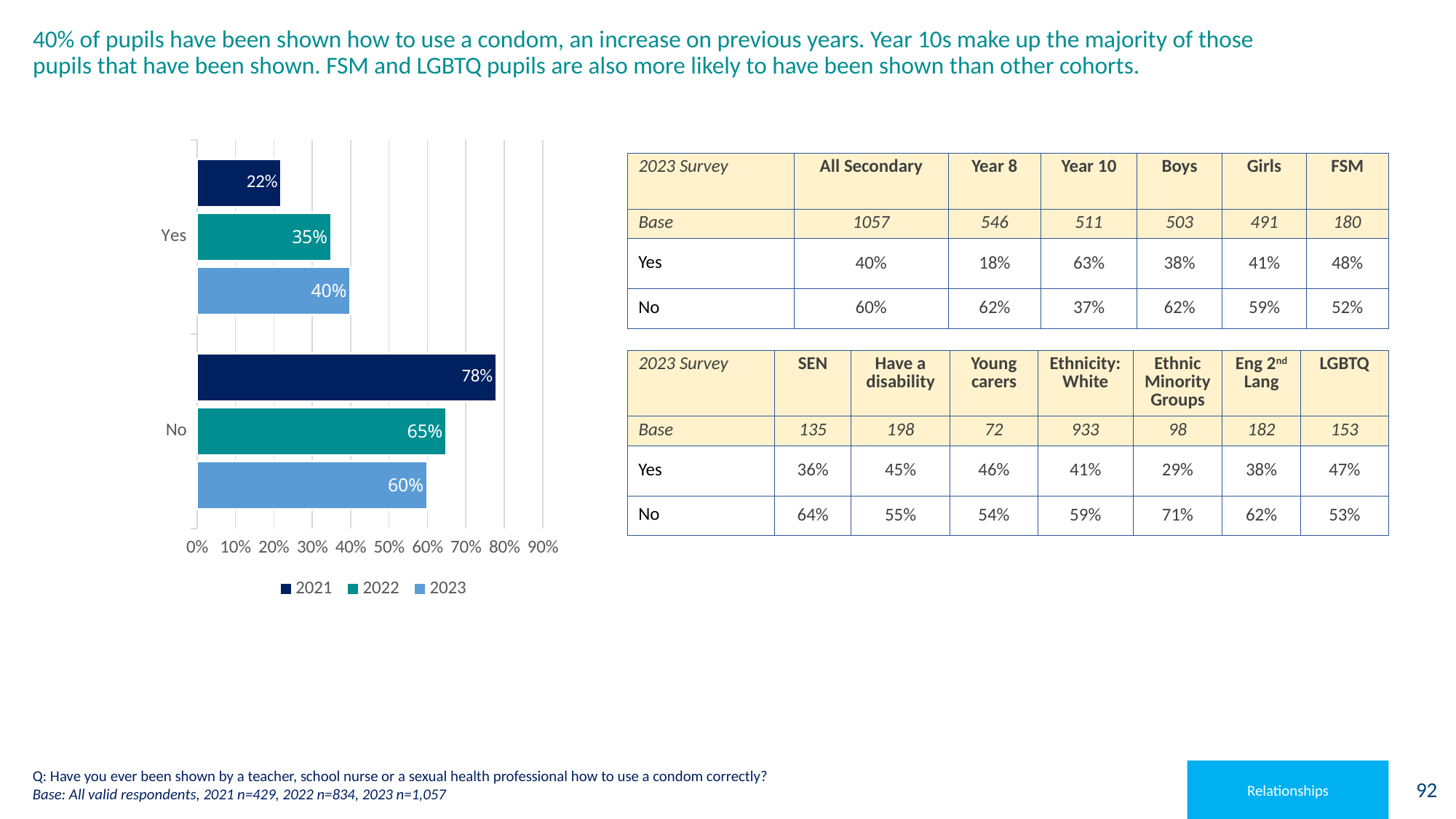
What kind of chart is shown on the slide? Bar chart Which year has the lowest value for 'No'? 2023 What is the value for 'Yes' in the 2023 series? 40% Which is larger: the 2022 value for 'No' or the 2023 value for 'No'? 2022 Is the 2021 value for 'No' greater or less than 70%? greater What is the value for 'No' in the 2021 series? 78% Which year has the highest value for 'Yes'? 2023 What is the value for 'Yes' in the 2022 series? 35% What is the value for 'No' in the 2023 series? 60% What is the difference between the 2023 and 2021 values for 'Yes'? 18% Do the values for 'Yes' rise or fall from 2021 to 2023? Rise How many series does the legend list? 3